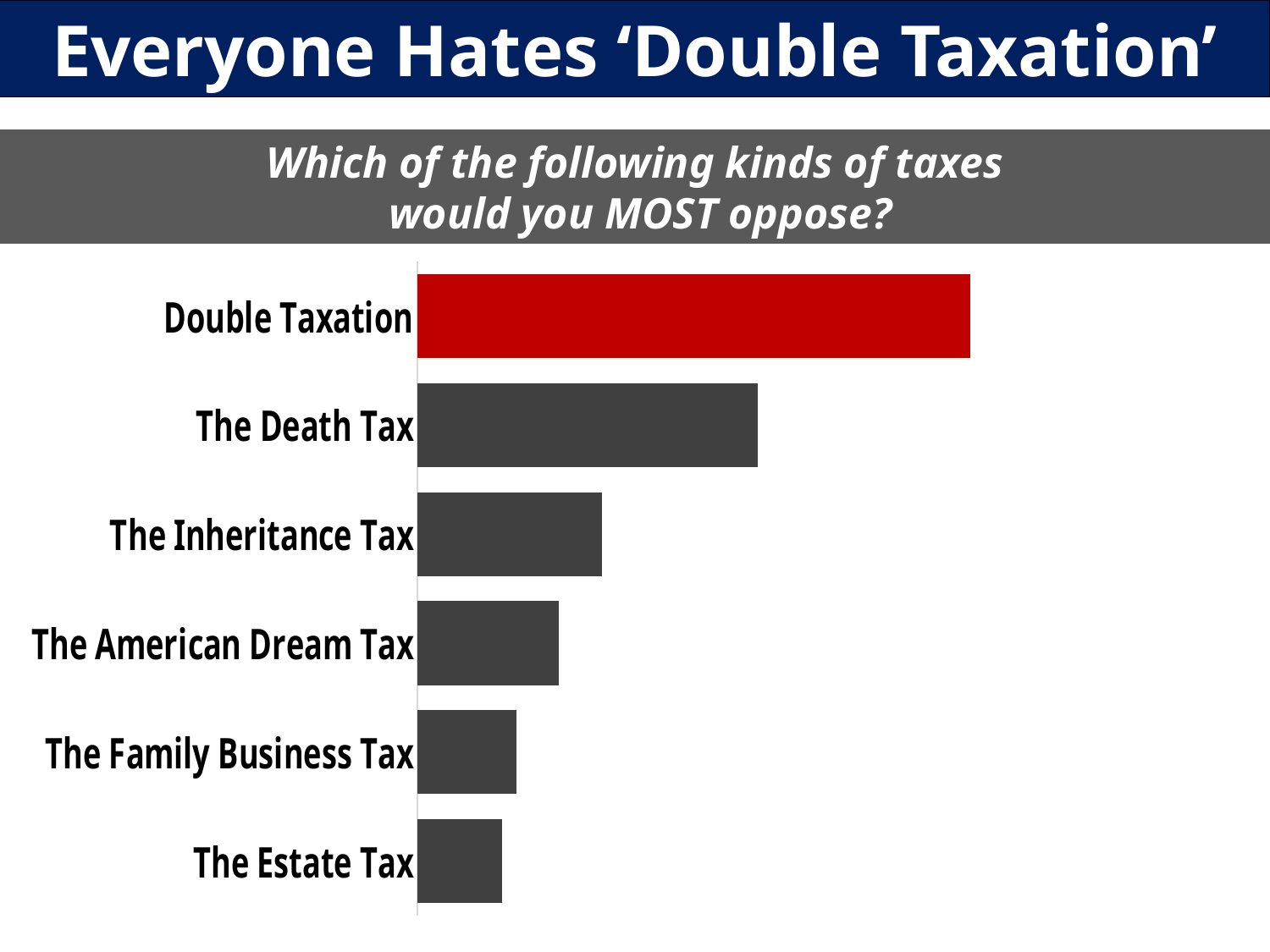
Which bar is longer, Double Taxation or The Estate Tax? Double Taxation Which bar is longer, The Death Tax or The Inheritance Tax? The Death Tax How many kinds of taxes are listed in the chart? 6 Which bar is longer, The Inheritance Tax or The American Dream Tax? The Inheritance Tax Which kind of tax has the longest bar? Double Taxation What kind of chart is shown on the slide? bar chart Which category's bar is coloured red? Double Taxation Going from the top of the chart to the bottom, do the bars get longer or shorter? shorter Which kind of tax has the second-longest bar? The Death Tax What is the title of the slide? Everyone Hates 'Double Taxation'